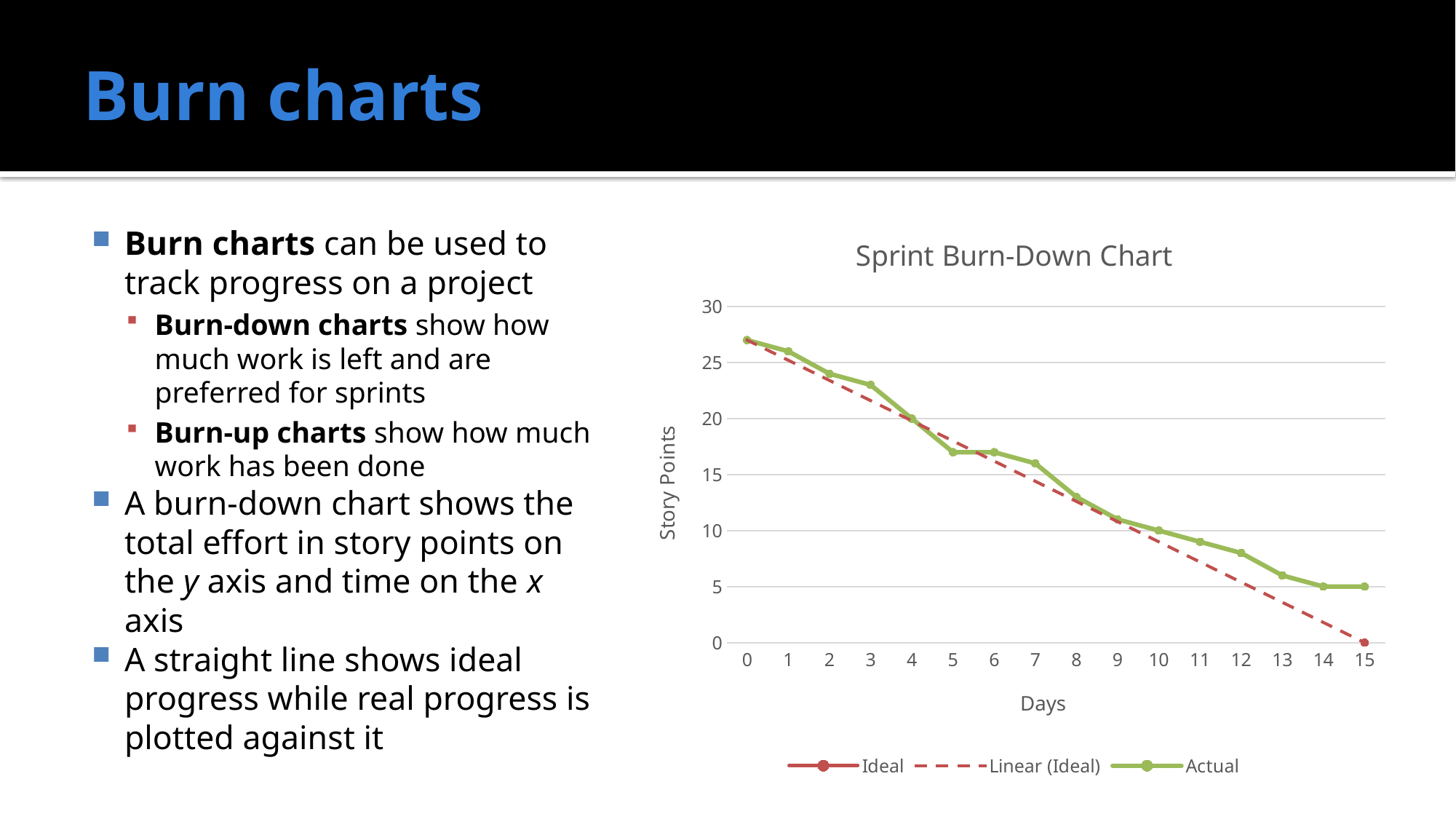
What type of chart is the Sprint Burn-Down Chart? line chart What is the label of the y axis in the Sprint Burn-Down Chart? Story Points In the Sprint Burn-Down Chart, is the Actual value at day 15 greater or less than 0? greater In the Sprint Burn-Down Chart, is the Actual value at day 1 greater or less than 25? greater In the Sprint Burn-Down Chart, is the Actual value at day 8 greater or less than 15? less How many day values are marked along the x axis of the Sprint Burn-Down Chart? 16 In the Sprint Burn-Down Chart, at day 15, which is higher: the Actual line or the Linear (Ideal) line? Actual In the Sprint Burn-Down Chart, on which day is the Actual value highest? 0 How many series does the legend of the Sprint Burn-Down Chart list? 3 Do the Actual story points rise or fall as the days increase in the Sprint Burn-Down Chart? fall What is the label of the x axis in the Sprint Burn-Down Chart? Days